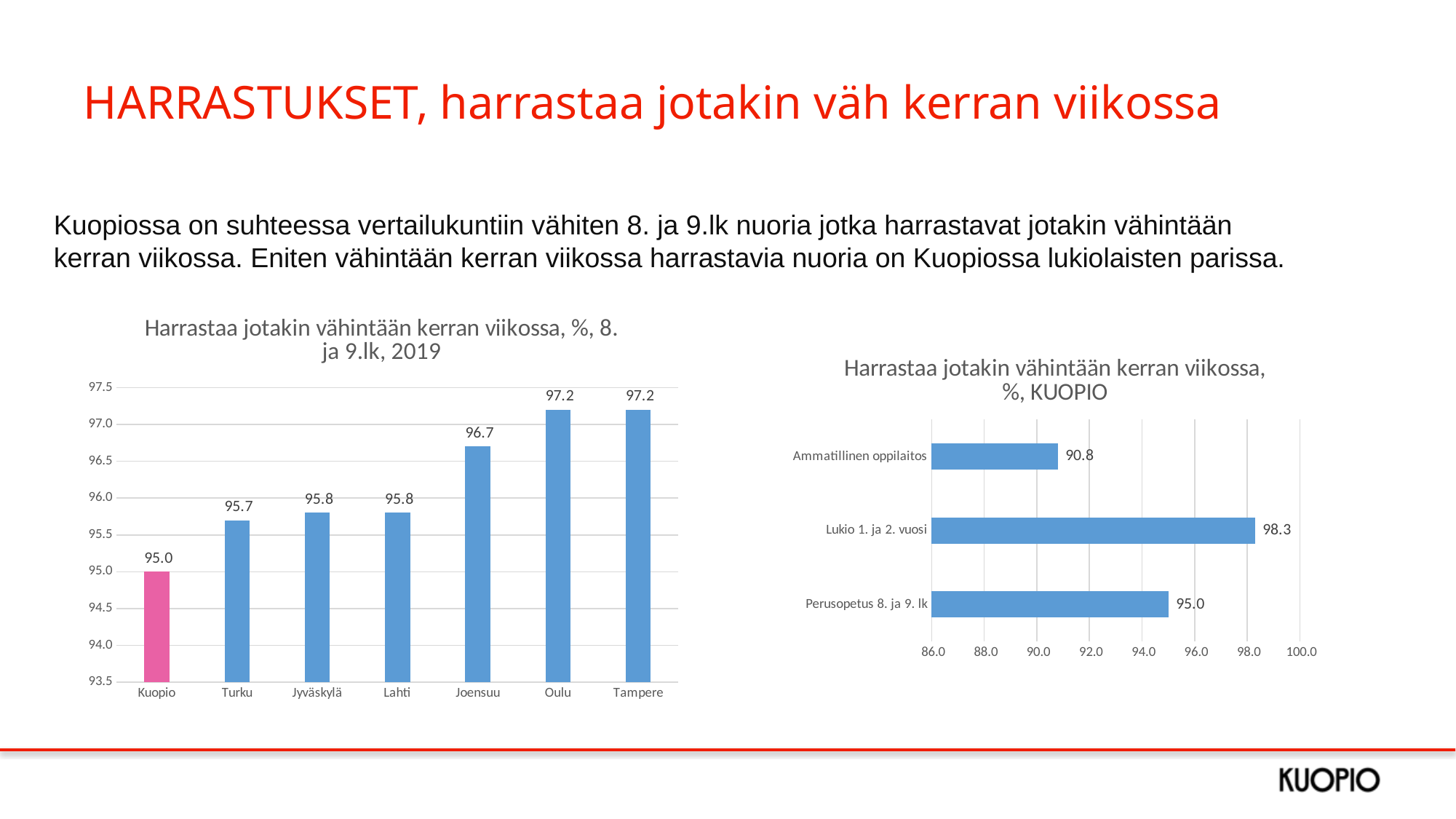
In the left chart (8. ja 9.lk, 2019), how many cities are shown? 7 In the right chart (KUOPIO), which category has the highest value? Lukio 1. ja 2. vuosi What kind of chart is the right chart (KUOPIO)? Bar chart In the right chart (KUOPIO), what is the value for Ammatillinen oppilaitos? 90.8 In the left chart (8. ja 9.lk, 2019), which city has the lowest value? Kuopio In the right chart (KUOPIO), what is the value for Lukio 1. ja 2. vuosi? 98.3 In the left chart (8. ja 9.lk, 2019), what is the value for Joensuu? 96.7 In the right chart (KUOPIO), what is the difference between Lukio 1. ja 2. vuosi and Ammatillinen oppilaitos? 7.5 In the left chart (8. ja 9.lk, 2019), which is larger, Turku or Joensuu? Joensuu In the left chart (8. ja 9.lk, 2019), what is the difference between Oulu and Kuopio? 2.2 In the left chart (8. ja 9.lk, 2019), what is the value for Kuopio? 95.0 In the left chart (8. ja 9.lk, 2019), which bar is coloured differently from the others? Kuopio